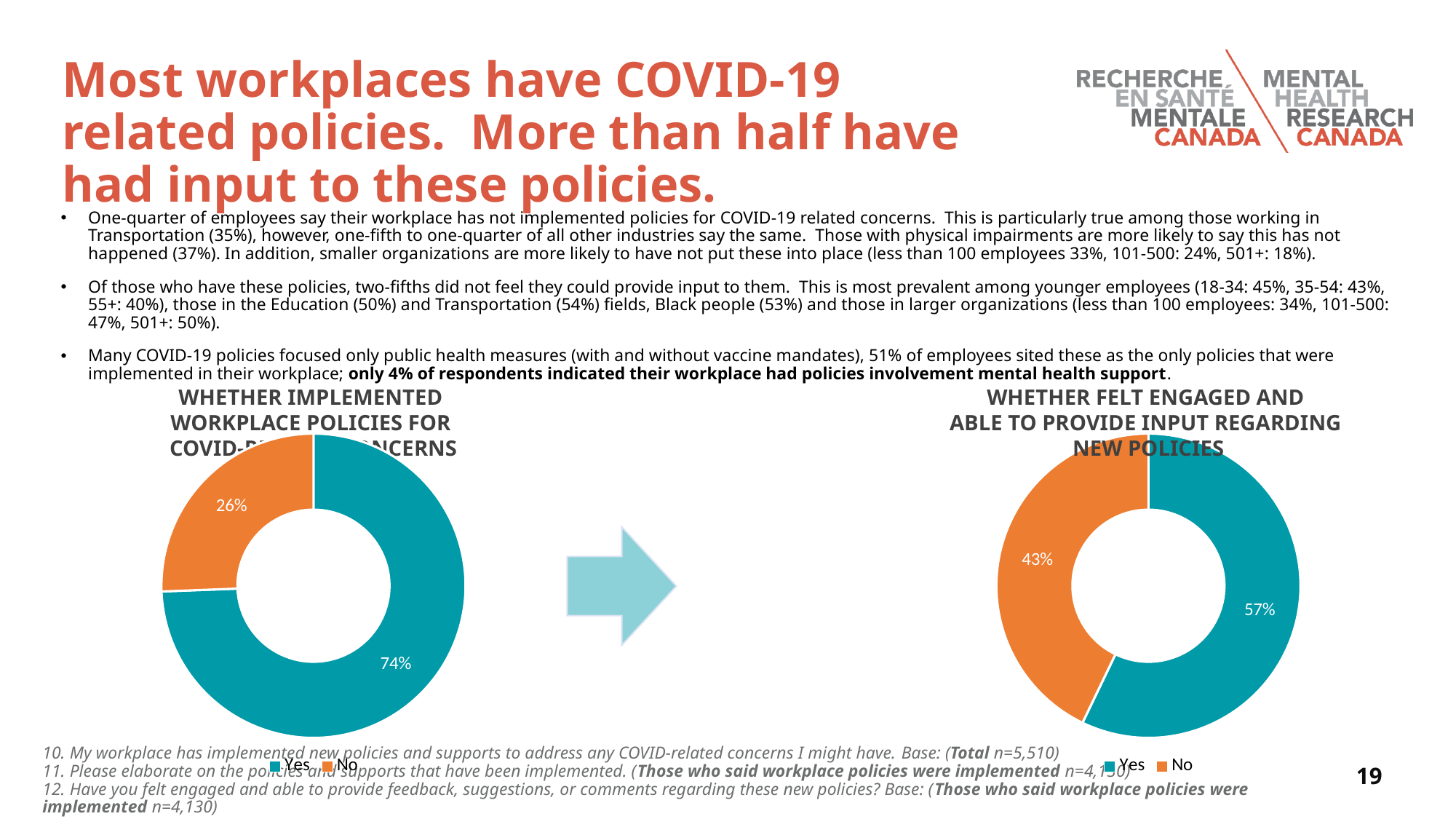
In the right chart, 'Whether felt engaged and able to provide input regarding new policies', what percentage answered Yes? 57% In the left chart, which colour represents the No response? Orange What type of chart is used on the right side of the slide? Donut (pie) chart In the right chart, which response has the smaller share? No In the left chart, which response has the larger share, Yes or No? Yes In the right chart, 'Whether felt engaged and able to provide input regarding new policies', what percentage answered No? 43% How many categories does the legend of the right chart list? 2 In the left chart, 'Whether implemented workplace policies for COVID-related concerns', what percentage answered No? 26% In the left chart, 'Whether implemented workplace policies for COVID-related concerns', what percentage answered Yes? 74% In the left chart, what is the difference in percentage points between the Yes and No shares? 48 Is the Yes share larger in the left chart or the right chart? Left chart In the right chart, what is the difference in percentage points between the Yes and No shares? 14